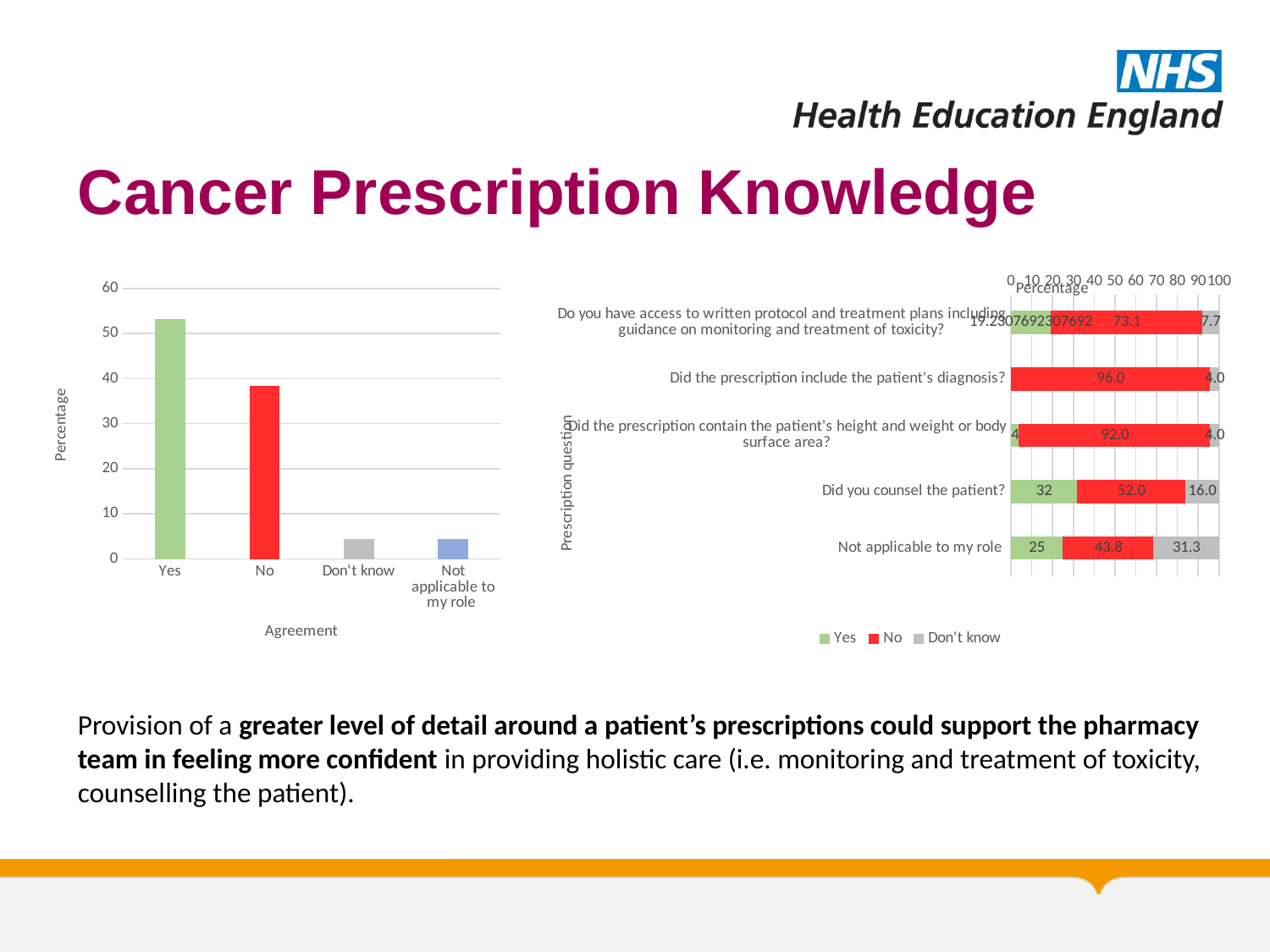
In the right chart, which prescription question has the highest No value? Did the prescription include the patient's diagnosis? What kind of chart is the chart on the right? stacked bar chart In the right chart, what is the No value for 'Did you counsel the patient?' 52.0 In the right chart, what is the difference between the No and Yes values for 'Did you counsel the patient?' 20 How many agreement categories are shown on the x axis of the left chart? 4 In the left chart, which agreement category has the highest bar? Yes In the right chart, what is the Don't know value for 'Not applicable to my role'? 31.3 In the left chart, is the value for Yes greater or less than 50? greater In the left chart, is the value for No greater or less than 30? greater How many series does the legend of the right chart list? 3 In the left chart, is the value for Don't know greater or less than 10? less In the right chart, which has the larger Yes value: 'Did you counsel the patient?' or 'Not applicable to my role'? Did you counsel the patient?